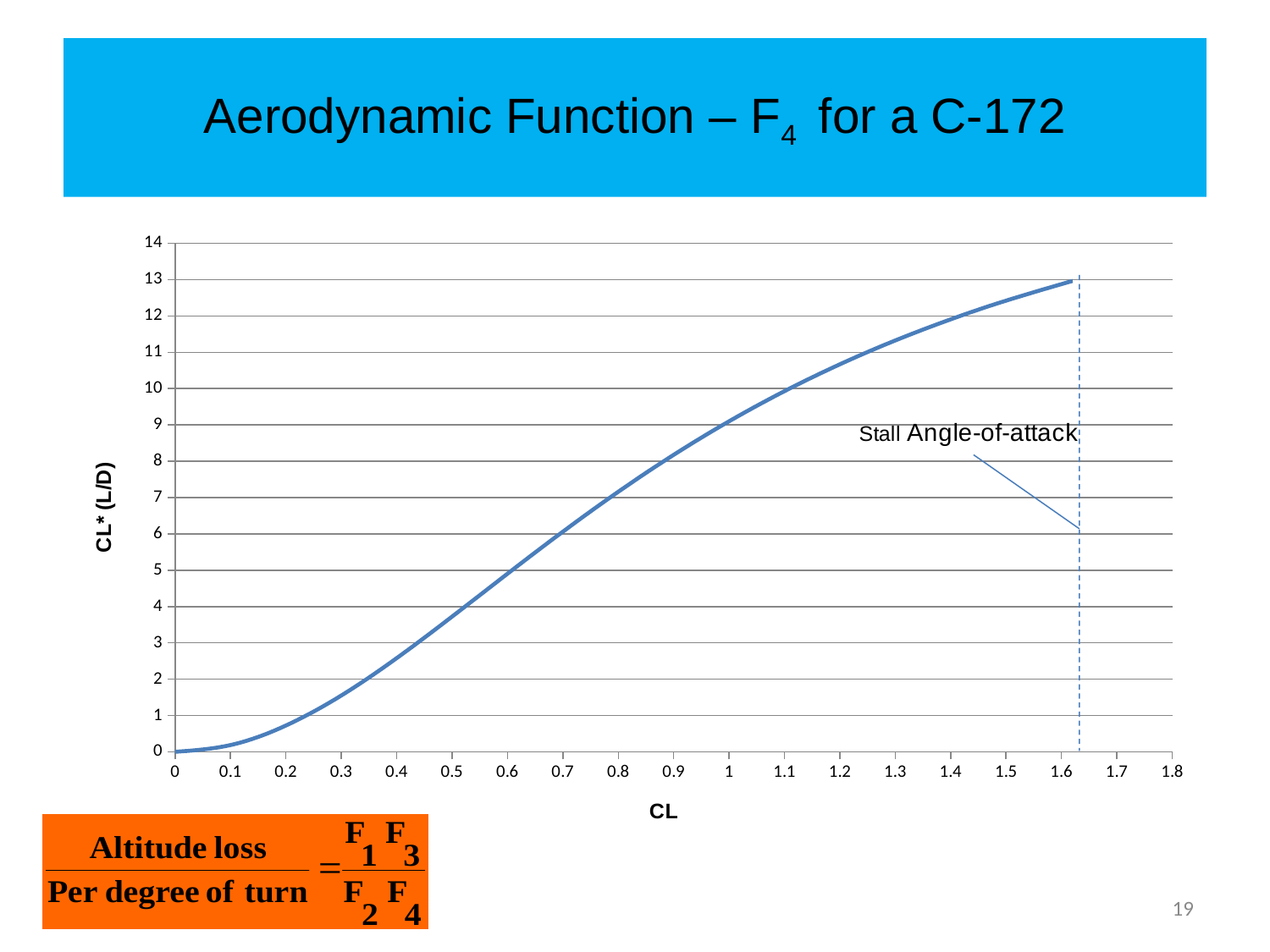
What kind of chart is shown on the slide? line chart How many tick labels are shown on the x axis? 19 Is the value of CL*(L/D) at CL = 1.3 greater or less than 10? greater Is the value of CL*(L/D) at CL = 0.8 greater or less than 9? less Is the value of CL*(L/D) at CL = 0.2 greater or less than 2? less What does the dashed vertical line near the right end of the curve mark? Stall Angle-of-attack What is the label of the y axis? CL* (L/D) Does the plotted value rise or fall as CL increases along the x axis? rise Which is larger, the value of CL*(L/D) at CL = 0.4 or at CL = 1.2? CL = 1.2